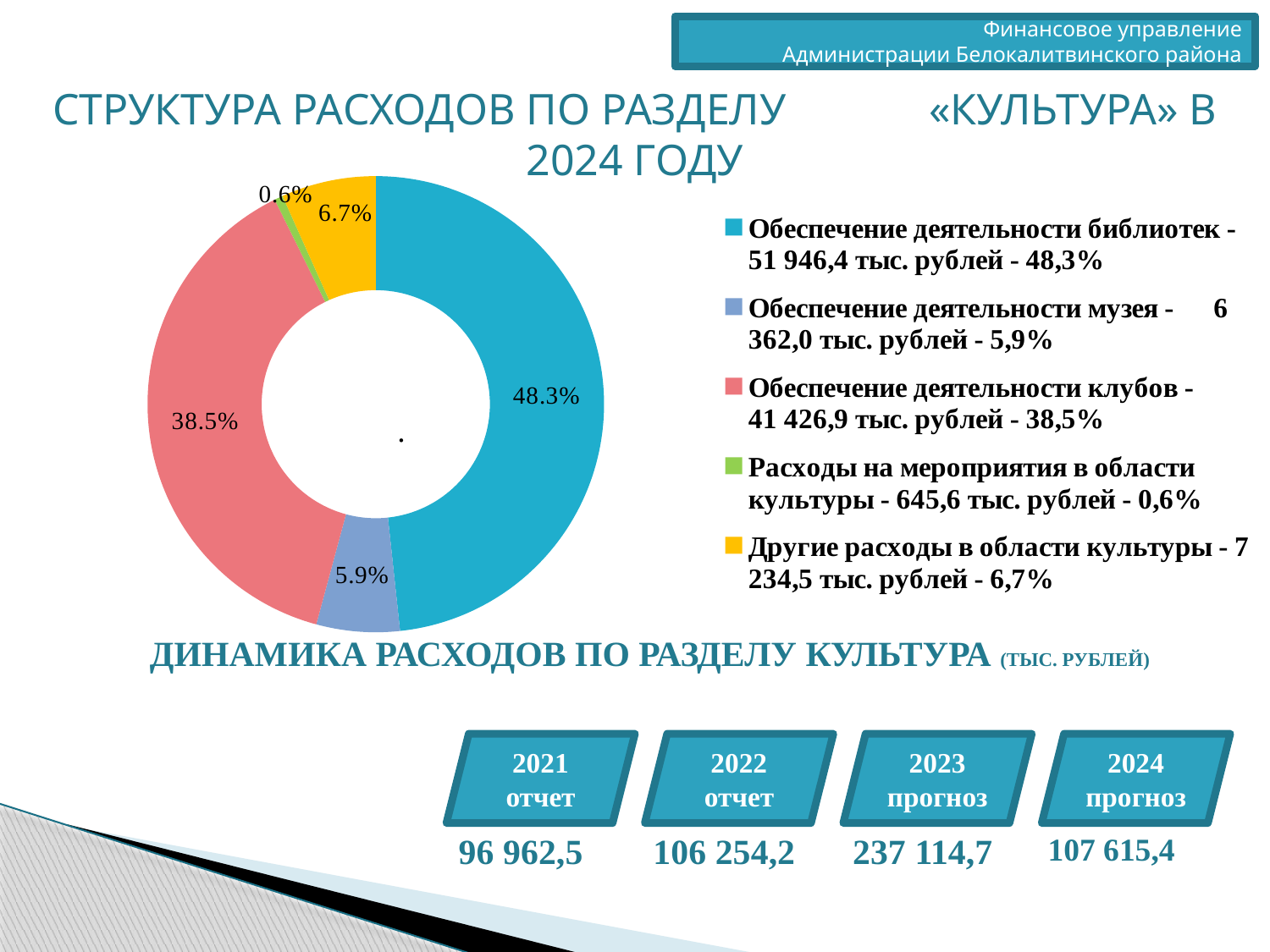
How many entries does the legend of the pie chart list? 5 How many slices does the pie chart have? 5 Which category has the largest slice in the pie chart? Обеспечение деятельности библиотек What share of the pie chart is labelled for «Обеспечение деятельности музея»? 5.9% What share of the pie chart is labelled for «Расходы на мероприятия в области культуры»? 0.6% Which slice is larger: «Обеспечение деятельности музея» or «Другие расходы в области культуры»? Другие расходы в области культуры What share of the pie chart is labelled for «Обеспечение деятельности библиотек»? 48.3% What kind of chart is shown on the slide? Pie (doughnut) chart By how many percentage points does the libraries slice (48.3%) exceed the clubs slice (38.5%)? 9.8 percentage points Which category has the smallest slice in the pie chart? Расходы на мероприятия в области культуры